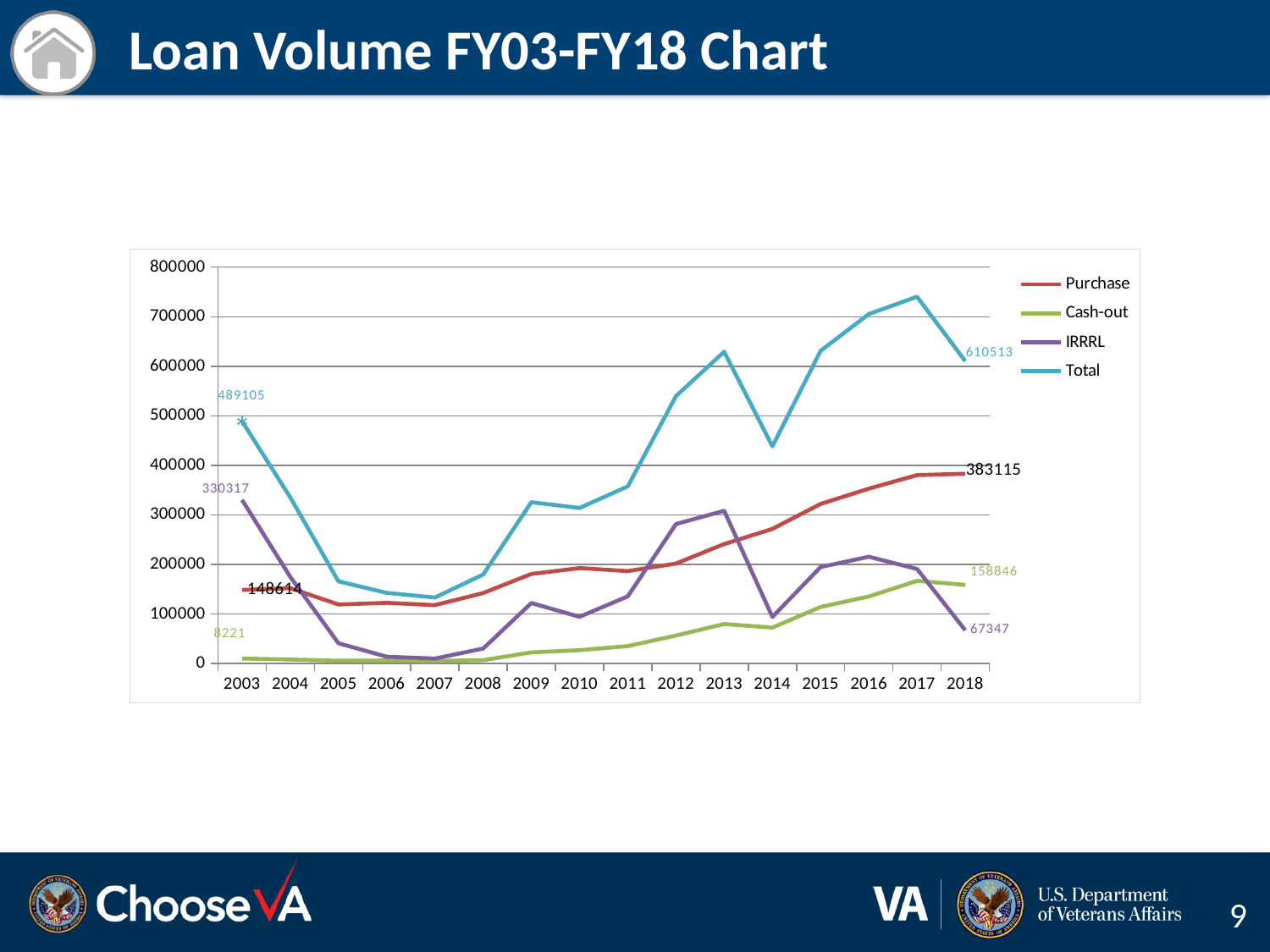
Is the Total value for 2017 greater or less than 700000? greater What kind of chart is shown on the slide? Line chart What is the value of the Total series in 2003? 489105 What is the IRRRL value in 2003? 330317 What is the Purchase value in 2018? 383115 Is the Total value for 2014 greater or less than 500000? less What is the Cash-out value in 2018? 158846 By how much did the Purchase value increase from 2003 to 2018? 234501 How many series does the legend list? 4 Which is larger, the IRRRL value in 2003 or in 2018? 2003 How many years are shown on the x axis? 16